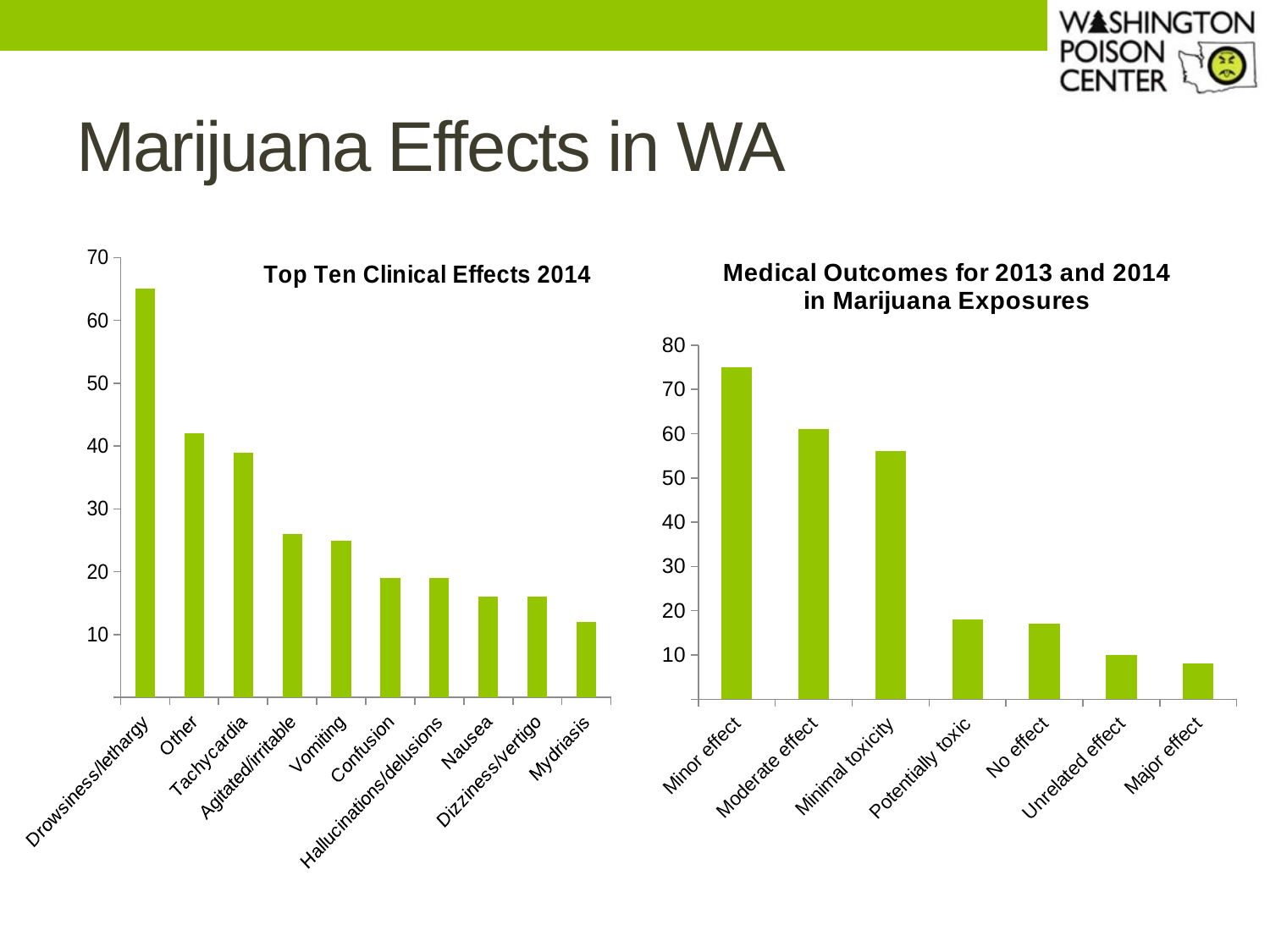
How many categories are shown in the 'Medical Outcomes for 2013 and 2014 in Marijuana Exposures' chart? 7 In the 'Medical Outcomes for 2013 and 2014 in Marijuana Exposures' chart, which category has the highest value? Minor effect In the 'Medical Outcomes for 2013 and 2014 in Marijuana Exposures' chart, which is larger, Moderate effect or Minimal toxicity? Moderate effect How many categories are shown in the 'Top Ten Clinical Effects 2014' chart? 10 In the 'Top Ten Clinical Effects 2014' chart, which category has the highest value? Drowsiness/lethargy In the 'Top Ten Clinical Effects 2014' chart, do the values rise or fall from left to right along the x axis? fall In the 'Top Ten Clinical Effects 2014' chart, which is larger, Other or Tachycardia? Other In the 'Medical Outcomes for 2013 and 2014 in Marijuana Exposures' chart, is the value for Minor effect greater or less than 70? greater In the 'Top Ten Clinical Effects 2014' chart, is the value for Drowsiness/lethargy greater or less than 60? greater What kind of chart is the 'Top Ten Clinical Effects 2014' chart? bar chart In the 'Medical Outcomes for 2013 and 2014 in Marijuana Exposures' chart, which category has the lowest value? Major effect In the 'Top Ten Clinical Effects 2014' chart, which category has the lowest value? Mydriasis